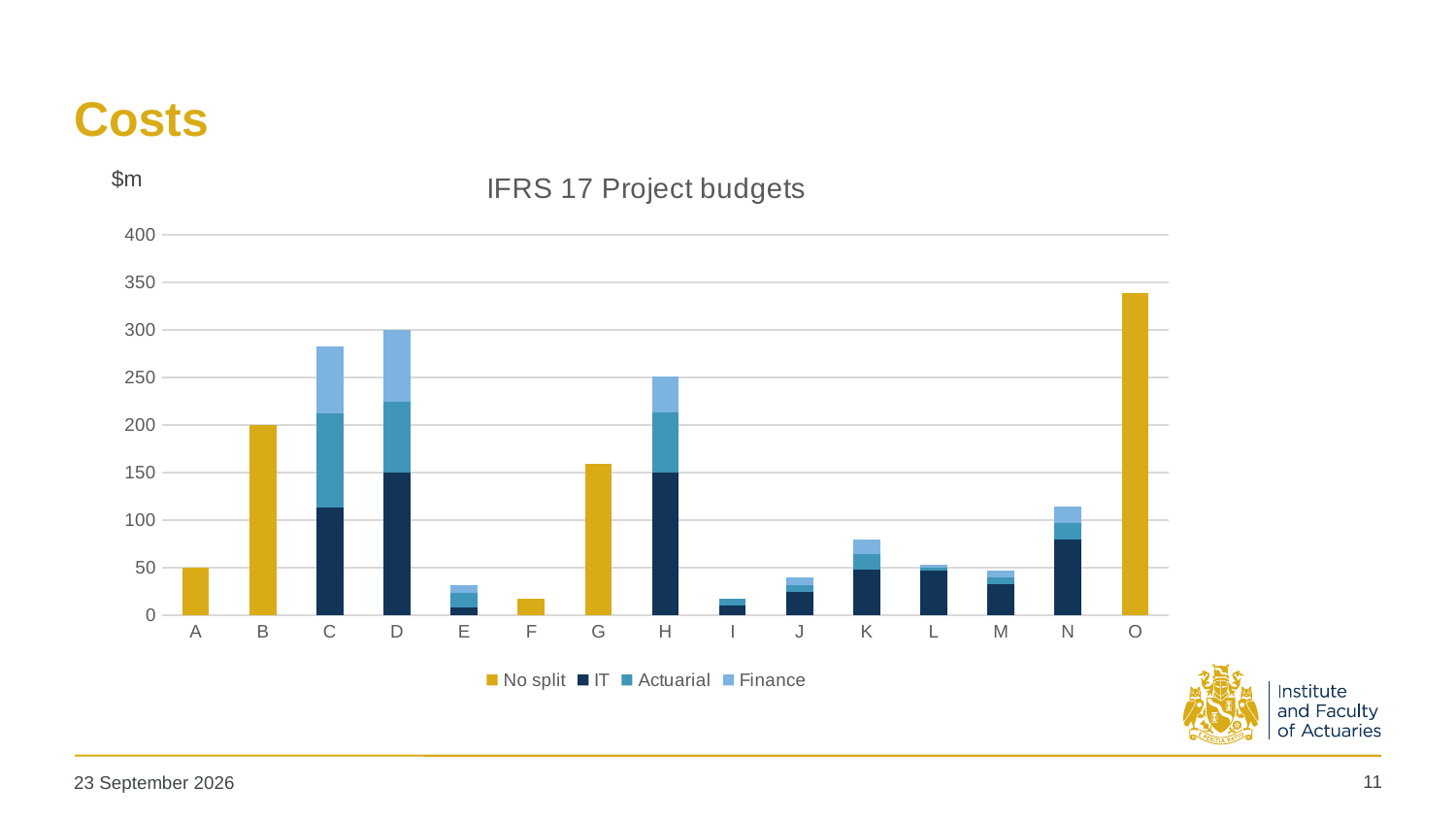
What is the total budget for category D? 300 Is the total for category E greater or less than 50? less How many categories are shown on the x axis? 15 Which has the larger total budget, category C or category H? C How many series does the legend list? 4 What type of chart is shown on the slide? Stacked bar chart What unit is shown for the values on the chart? $m What is the title of the chart? IFRS 17 Project budgets Which category has the highest total budget? O What is the total budget for category B? 200 Is the total for category O greater or less than 300? greater